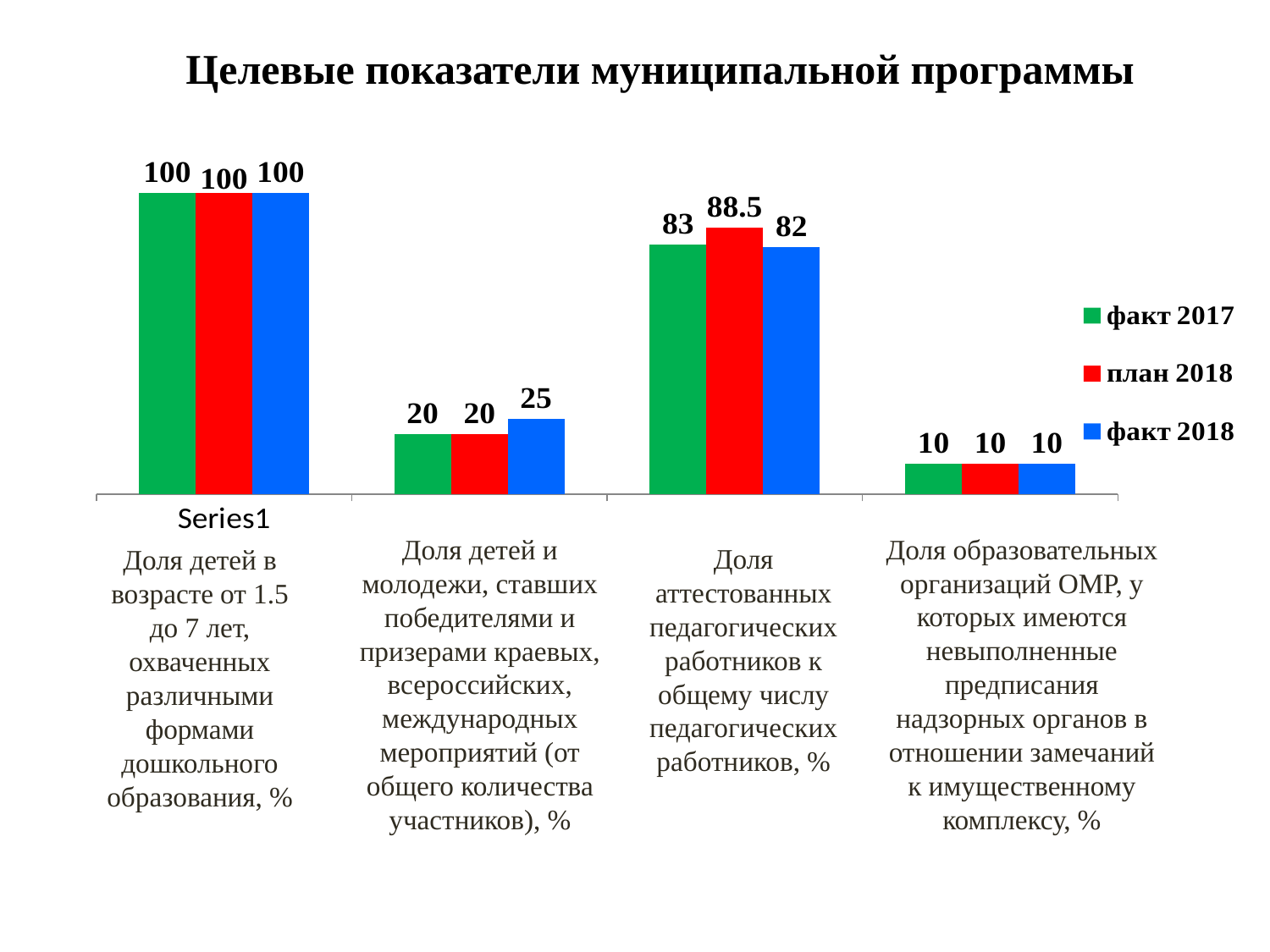
What is the value of факт 2018 for the share of children and youth who became winners and prize-winners (Доля детей и молодежи, ставших победителями и призерами)? 25 Which category has the highest values across all three series? Доля детей в возрасте от 1.5 до 7 лет, охваченных различными формами дошкольного образования, % For the share of children and youth who became winners and prize-winners, which is larger: факт 2017 or факт 2018? факт 2018 What is the title of the chart on the slide? Целевые показатели муниципальной программы How many categories (groups of bars) are plotted in the chart? 4 What is the value of план 2018 for the share of certified pedagogical workers (Доля аттестованных педагогических работников)? 88.5 What is the difference between план 2018 and факт 2018 for the share of certified pedagogical workers? 6.5 What kind of chart is shown on the slide? bar chart Which category has the lowest values across all three series? Доля образовательных организаций ОМР, у которых имеются невыполненные предписания надзорных органов в отношении замечаний к имущественному комплексу, % What is the value of факт 2018 for the share of educational organizations with unfulfilled prescriptions (Доля образовательных организаций ОМР)? 10 How many series does the legend list? 3 What is the value of факт 2017 for the share of certified pedagogical workers (Доля аттестованных педагогических работников)? 83